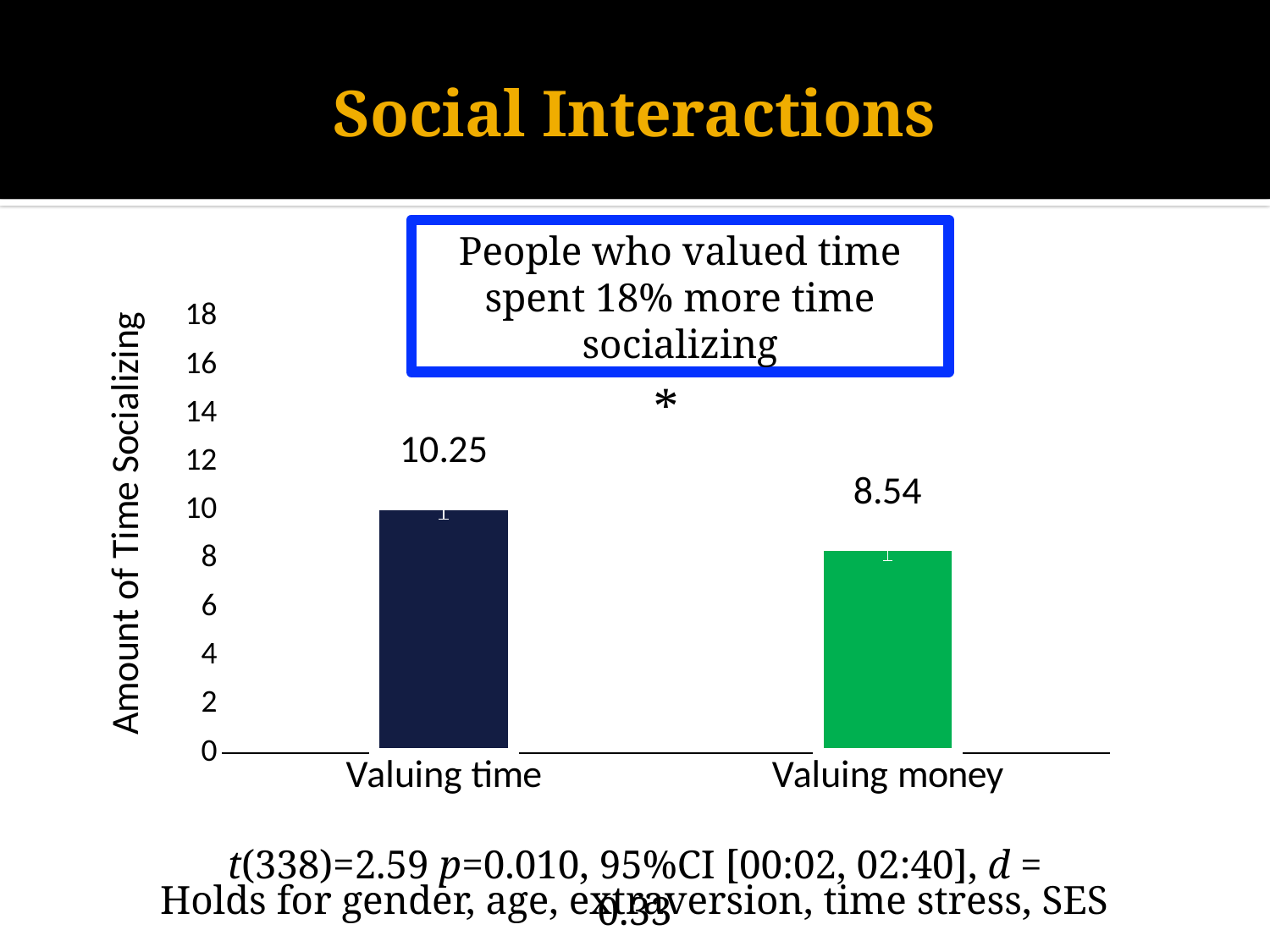
What is the label of the y axis? Amount of Time Socializing How many categories are shown on the x axis? 2 Which is larger, the value for Valuing time or the value for Valuing money? Valuing time What is the maximum value shown on the y axis? 18 Is the value for Valuing time greater or less than 8? greater What is the value for Valuing money? 8.54 Is the value for Valuing money greater or less than 10? less What is the difference between the values for Valuing time and Valuing money? 1.71 What is the value for Valuing time? 10.25 Which category has the highest value? Valuing time Which category has the lowest value? Valuing money What kind of chart is shown on the slide? bar chart